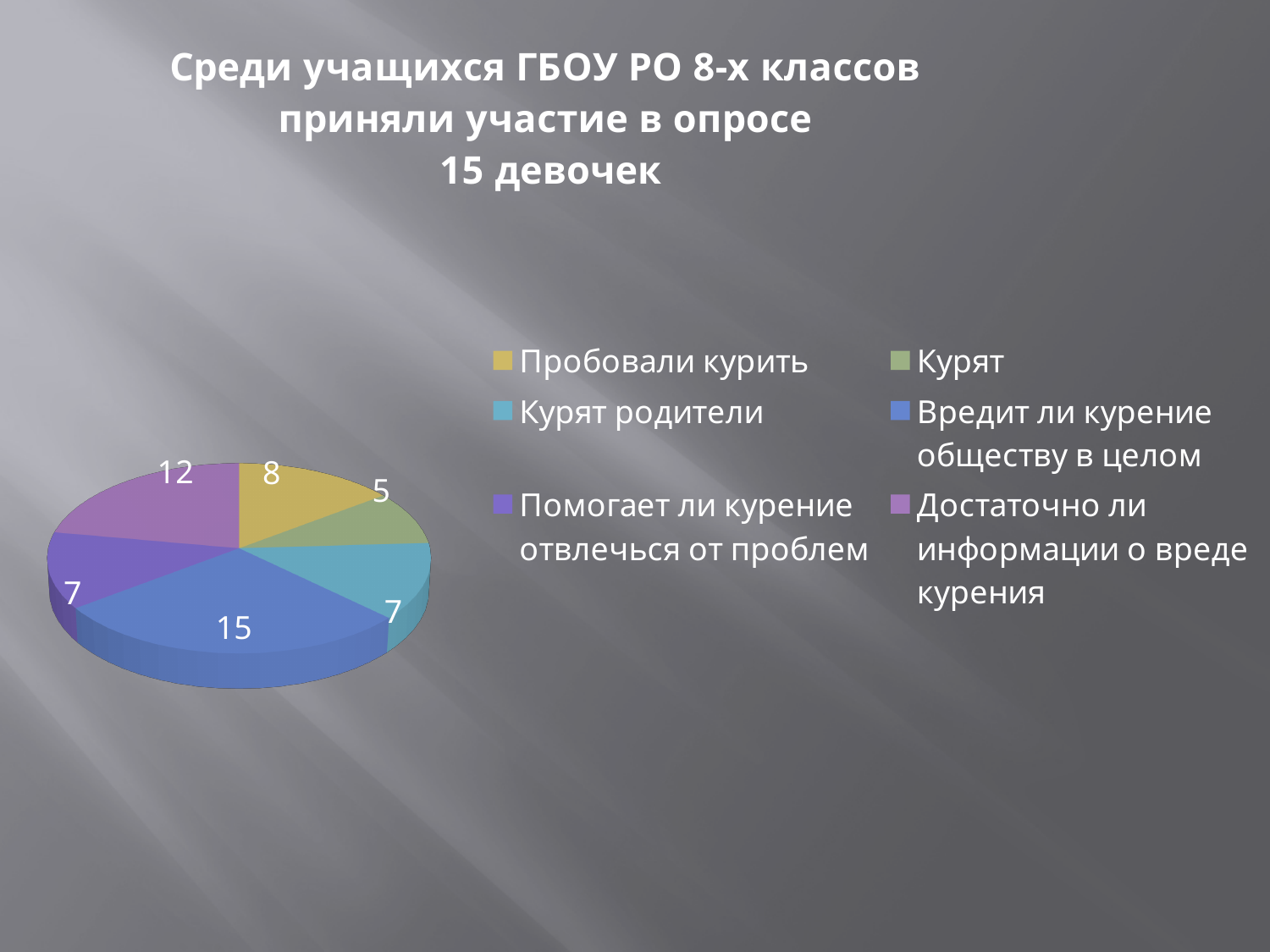
Which category has the largest slice? Вредит ли курение обществу в целом What is the value for "Вредит ли курение обществу в целом"? 15 How many slices does the pie chart have? 6 Which is larger, the value for "Пробовали курить" or the value for "Курят родители"? Пробовали курить Which category has the smallest slice? Курят What kind of chart is shown on the slide? Pie chart What is the value for "Курят"? 5 What colour is the slice for "Пробовали курить"? Yellow What is the value for "Достаточно ли информации о вреде курения"? 12 What is the difference between the values for "Вредит ли курение обществу в целом" and "Достаточно ли информации о вреде курения"? 3 What is the value for "Пробовали курить"? 8 How many entries does the legend list? 6